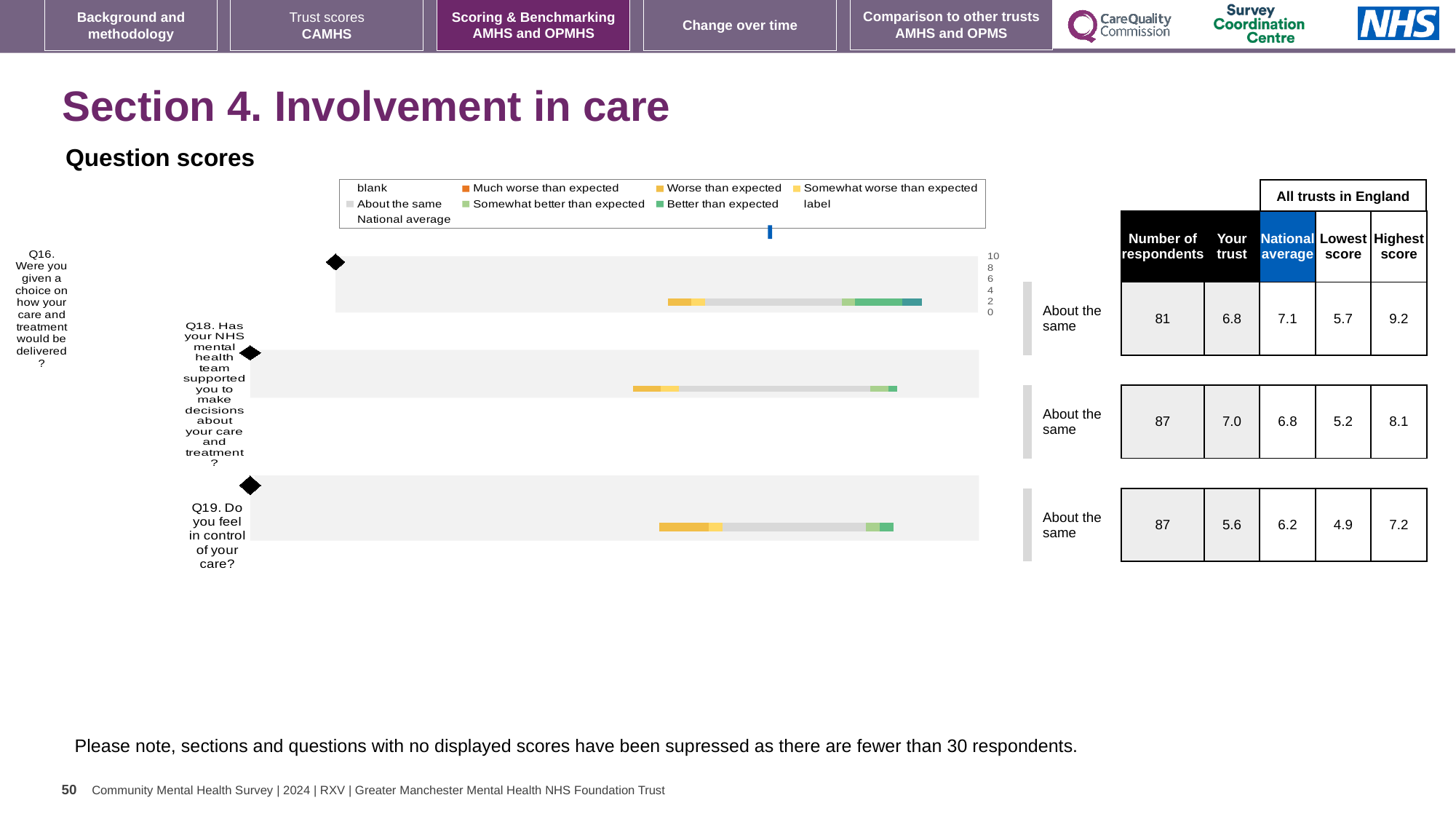
What benchmark category is shown next to each of the three questions? About the same What is the difference between the highest score and the lowest score for Q16? 3.5 For Q18, which is larger: the 'Your trust' score or the national average? Your trust What is the highest score among all trusts in England for Q16? 9.2 How many questions are plotted in the question scores chart? 3 What is the maximum value shown on the score axis of the question scores chart? 10 What is the national average score for Q19 (Do you feel in control of your care?)? 6.2 What kind of chart is used to show the question scores on this slide? Bar chart How many respondents are listed for Q18 (Has your NHS mental health team supported you to make decisions about your care and treatment?)? 87 What does the orange legend entry in the question scores chart represent? Much worse than expected Which question has the lowest 'Your trust' score? Q19 What is the 'Your trust' score for Q16 (Were you given a choice on how your care and treatment would be delivered?)? 6.8